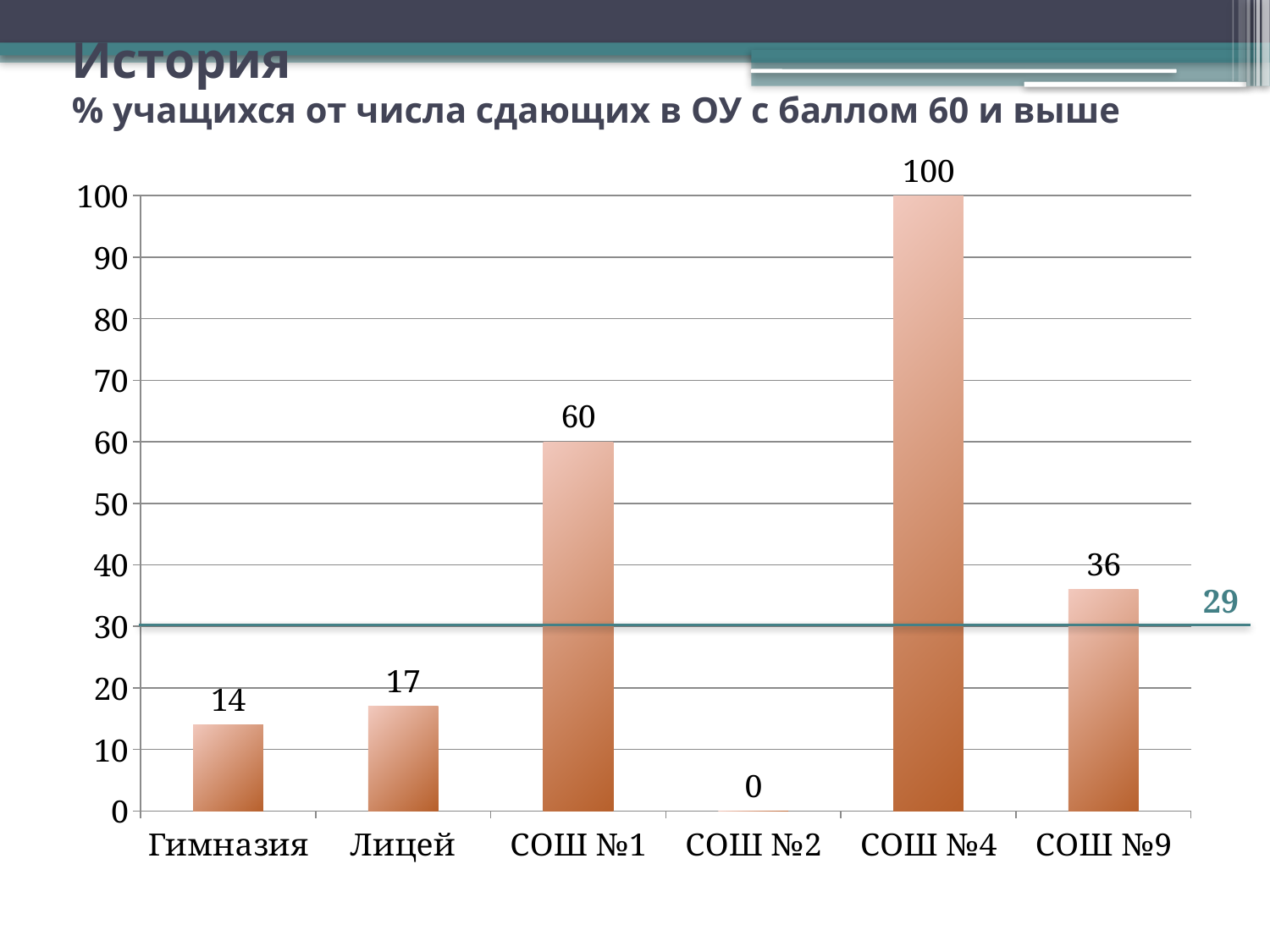
What value is labelled on the horizontal reference line drawn across the chart? 29 What is the value for СОШ №9? 36 Which category has the highest value? СОШ №4 Which is larger, the value for Лицей or the value for Гимназия? Лицей How many categories are shown on the x axis? 6 What kind of chart is this? bar chart Which category has the lowest value? СОШ №2 What is the value for СОШ №1? 60 Is the value for СОШ №9 greater or less than 30? greater What is the difference between the values for СОШ №4 and СОШ №1? 40 What is the value for Гимназия? 14 What is the value for Лицей? 17